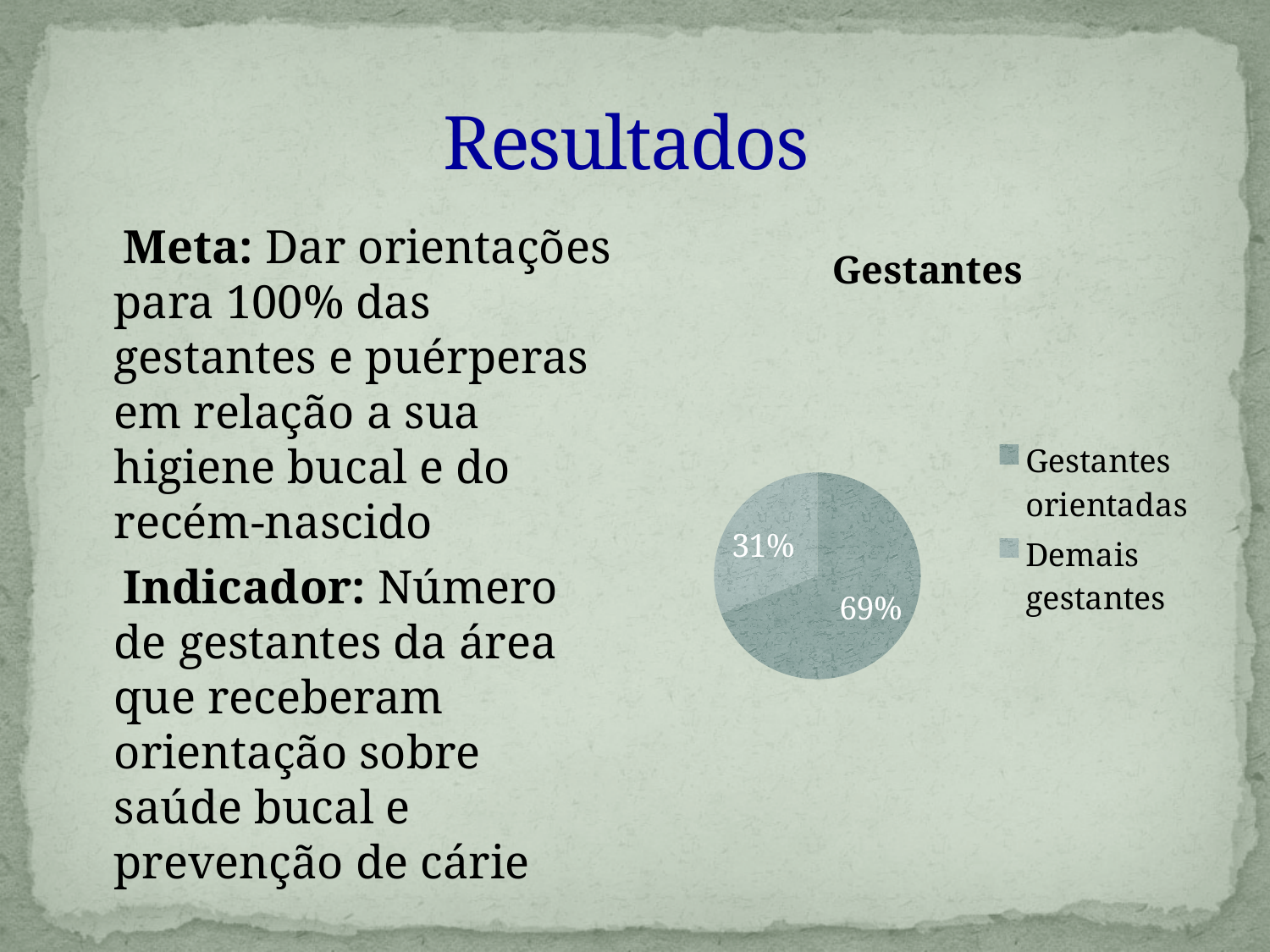
What kind of chart is shown on the slide? pie chart Which is larger: the slice for 'Gestantes orientadas' or the slice for 'Demais gestantes'? Gestantes orientadas Which slice of the pie chart is the largest? Gestantes orientadas Which slice of the pie chart is the smallest? Demais gestantes How many entries does the legend of the chart list? 2 How many slices does the pie chart have? 2 What share of the pie is labelled for 'Demais gestantes'? 31% What is the difference in percentage points between the two slices of the pie chart? 38 What are the two legend entries of the chart? Gestantes orientadas; Demais gestantes What is the title of the chart? Gestantes What share of the pie is labelled for 'Gestantes orientadas'? 69%